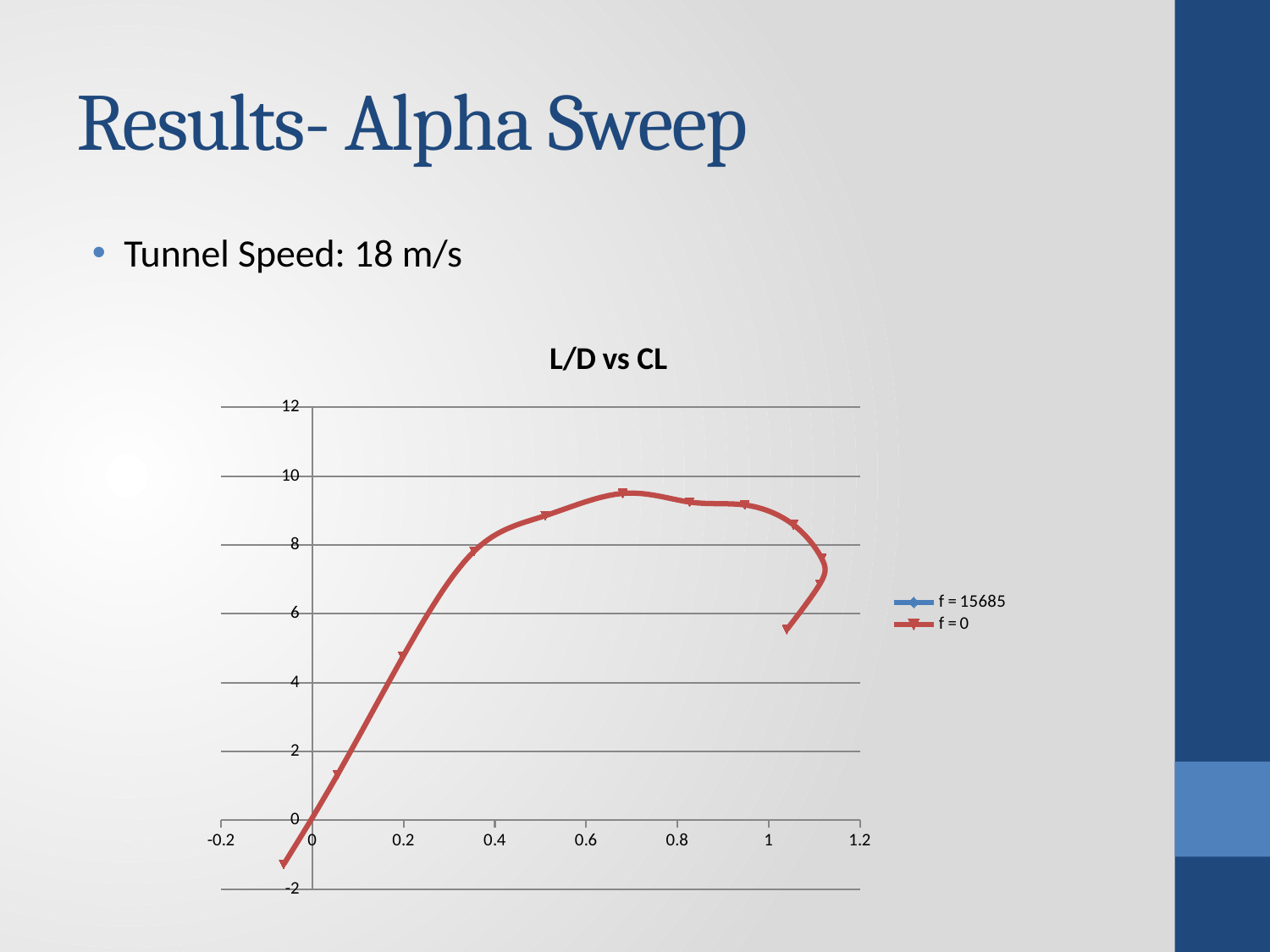
Does the f = 0 series rise or fall between CL = 0 and CL = 0.4? rise What is the title of the chart? L/D vs CL How many series does the legend list? 2 What is the highest value shown on the vertical axis? 12 Is the value of the f = 0 series at CL = 0.2 greater or less than 4? greater Is the peak value of the f = 0 series greater or less than 8? greater What kind of chart is shown on the slide? line chart Is the peak value of the f = 0 series greater or less than 10? less Which series is drawn in red? f = 0